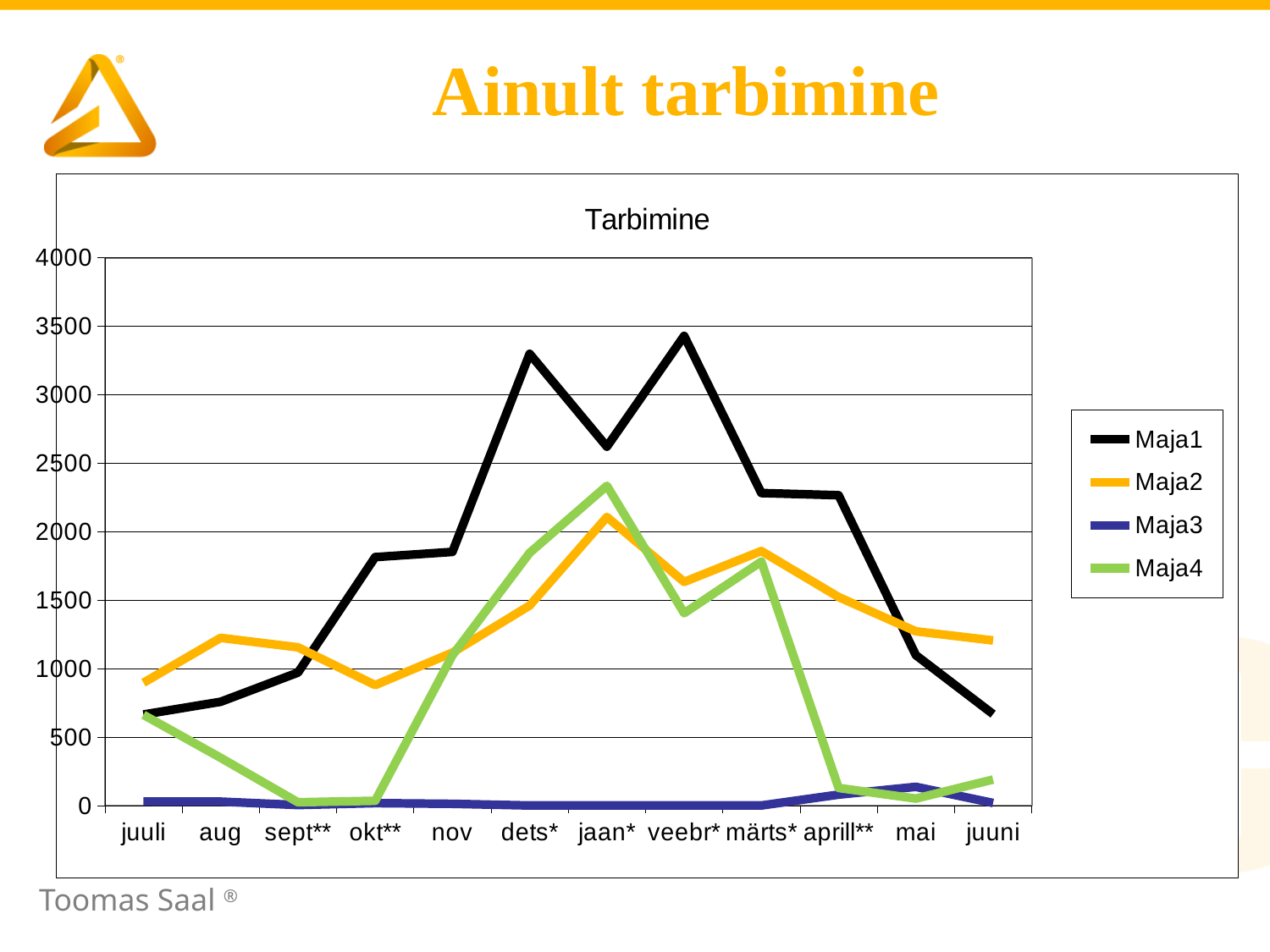
In which month does Maja2 reach its highest value? jaan* In which month does Maja4 reach its highest value? jaan* How many categories are shown on the x axis? 12 Is the value for Maja1 in dets* greater or less than 3000? greater Is the value for Maja1 in juuni greater or less than 1000? less What is the title of the chart? Tarbimine Does the Maja1 line rise or fall from veebr* to juuni? fall What kind of chart is shown on the slide? line chart Which series has the higher value in dets*, Maja1 or Maja2? Maja1 How many series does the legend list? 4 Is the value for Maja4 in jaan* greater or less than 2000? greater Which colour is used for the Maja1 series? black